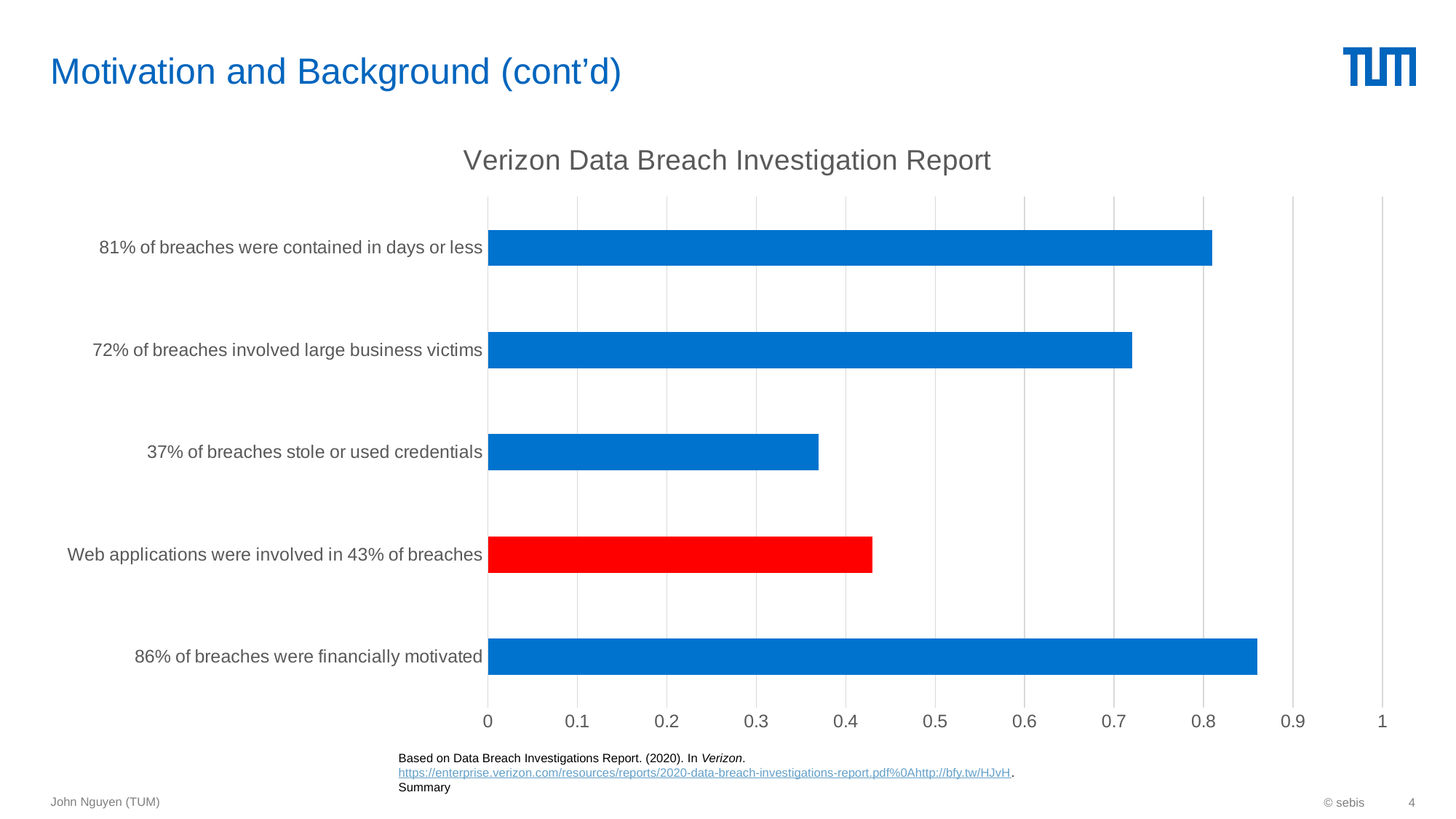
Which category has the shortest bar? 37% of breaches stole or used credentials What kind of chart is shown on the slide? bar chart Which bar is drawn in red rather than blue? Web applications were involved in 43% of breaches Is the bar for "72% of breaches involved large business victims" greater or less than 0.8? less What is the title of the chart? Verizon Data Breach Investigation Report Which bar is longer: the one for breaches contained in days or less, or the one for breaches involving large business victims? 81% of breaches were contained in days or less What is the highest tick value shown on the horizontal axis? 1 How many bars (categories) does the chart show? 5 Is the bar for "Web applications were involved in 43% of breaches" greater or less than 0.4? greater Which category has the longest bar? 86% of breaches were financially motivated Is the bar for "37% of breaches stole or used credentials" greater or less than 0.4? less What percentage of breaches were financially motivated, according to the chart label? 86%